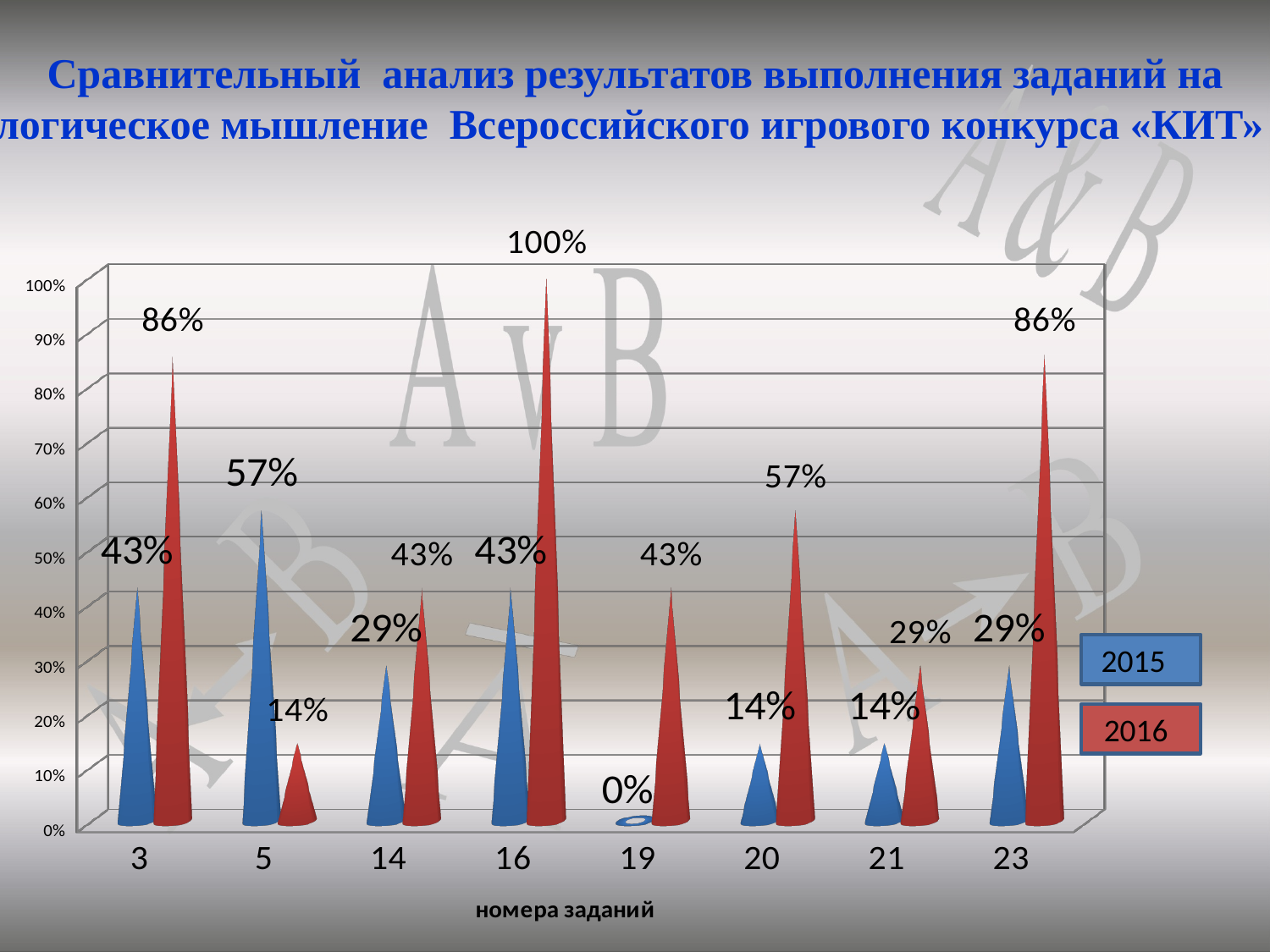
What is the value for task 5 in the 2015 series? 57% Which is larger for task 5: the 2015 value or the 2016 value? 2015 What is the value for task 23 in the 2016 series? 86% How many tasks (categories) are shown on the x axis? 8 What kind of chart is shown on the slide? bar chart What is the label of the x axis? номера заданий How many series does the legend list? 2 Which task has the lowest value in the 2015 series? 19 What is the value for task 16 in the 2016 series? 100% Which task has the highest value in the 2016 series? 16 What is the difference between the 2016 and 2015 values for task 3? 43% What is the value for task 19 in the 2015 series? 0%